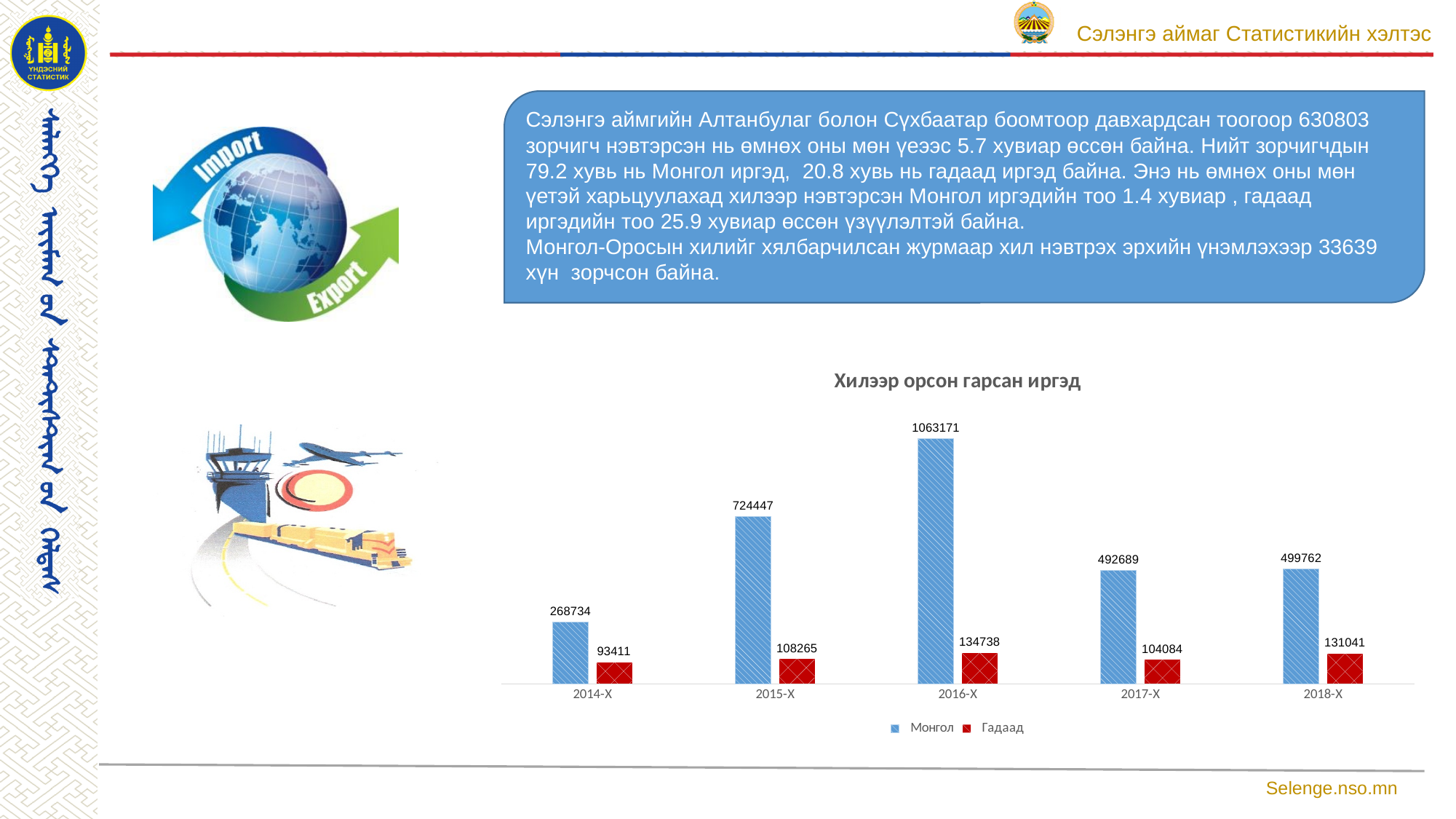
What is the value for Монгол in 2016-X? 1063171 What is the difference between the Монгол and Гадаад values in 2016-X? 928433 What type of chart is shown under the title 'Хилээр орсон гарсан иргэд'? bar chart What is the value for Гадаад in 2014-X? 93411 How many years are shown on the x axis? 5 What is the title of the chart? Хилээр орсон гарсан иргэд In which year is the Монгол value highest? 2016-X What is the value for Гадаад in 2018-X? 131041 What is the value for Монгол in 2015-X? 724447 In which year is the Гадаад value lowest? 2014-X Which is larger, the Монгол value in 2015-X or the Монгол value in 2017-X? 2015-X How many series does the legend list? 2